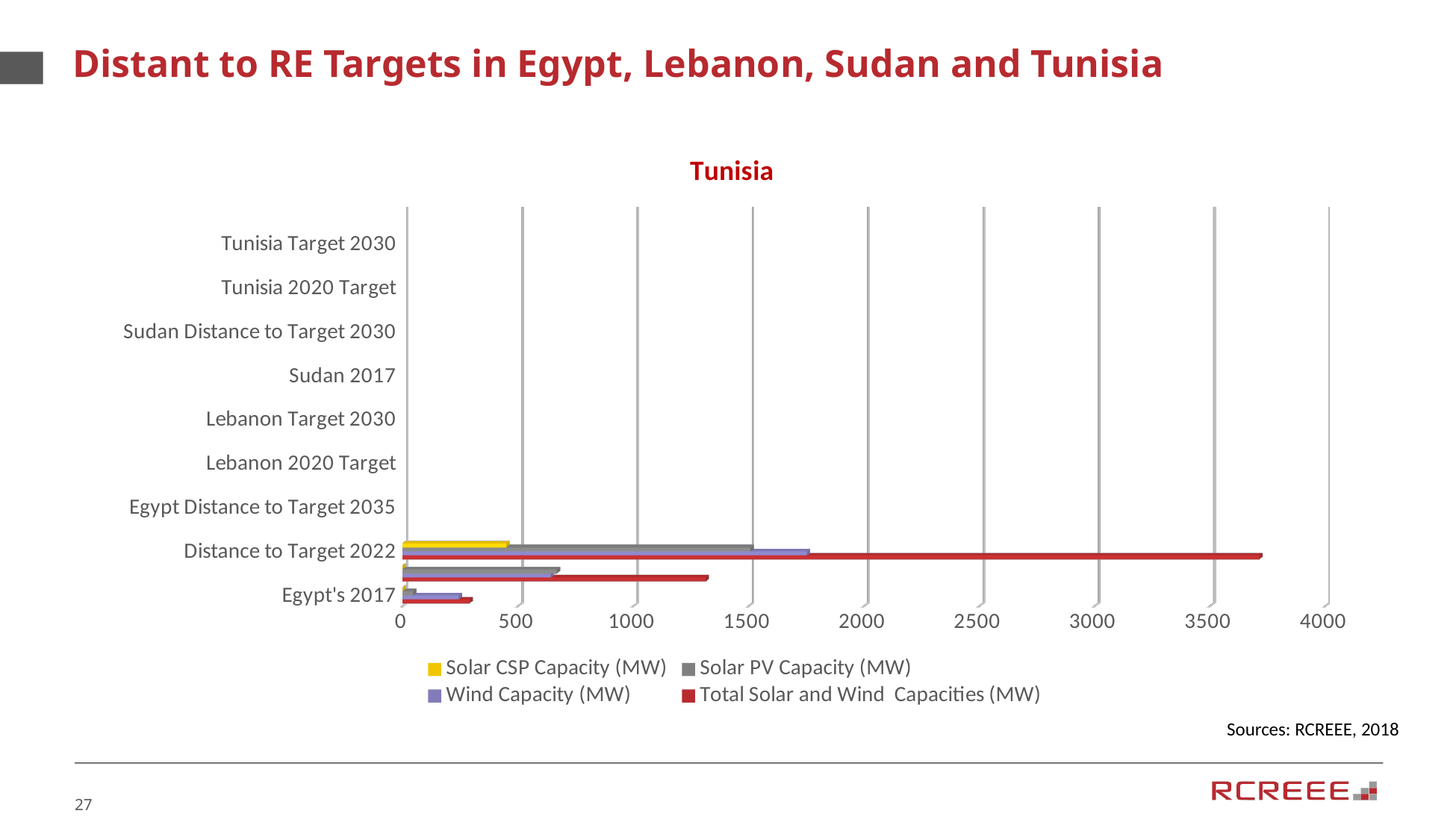
How many category labels are shown on the vertical axis of the chart? 9 For Distance to Target 2022, which is larger: Wind Capacity (MW) or Solar CSP Capacity (MW)? Wind Capacity (MW) Is the Total Solar and Wind Capacities (MW) value for Distance to Target 2022 greater or less than 3500? greater Is the Solar CSP Capacity (MW) value for Distance to Target 2022 greater or less than 500? less What is the title of the chart? Tunisia Is the Wind Capacity (MW) value for Distance to Target 2022 greater or less than 1500? greater What kind of chart is shown on the slide? bar chart How many series does the legend list? 4 Which colour represents Solar CSP Capacity (MW) in the legend? yellow For Distance to Target 2022, which series has the highest value? Total Solar and Wind Capacities (MW)